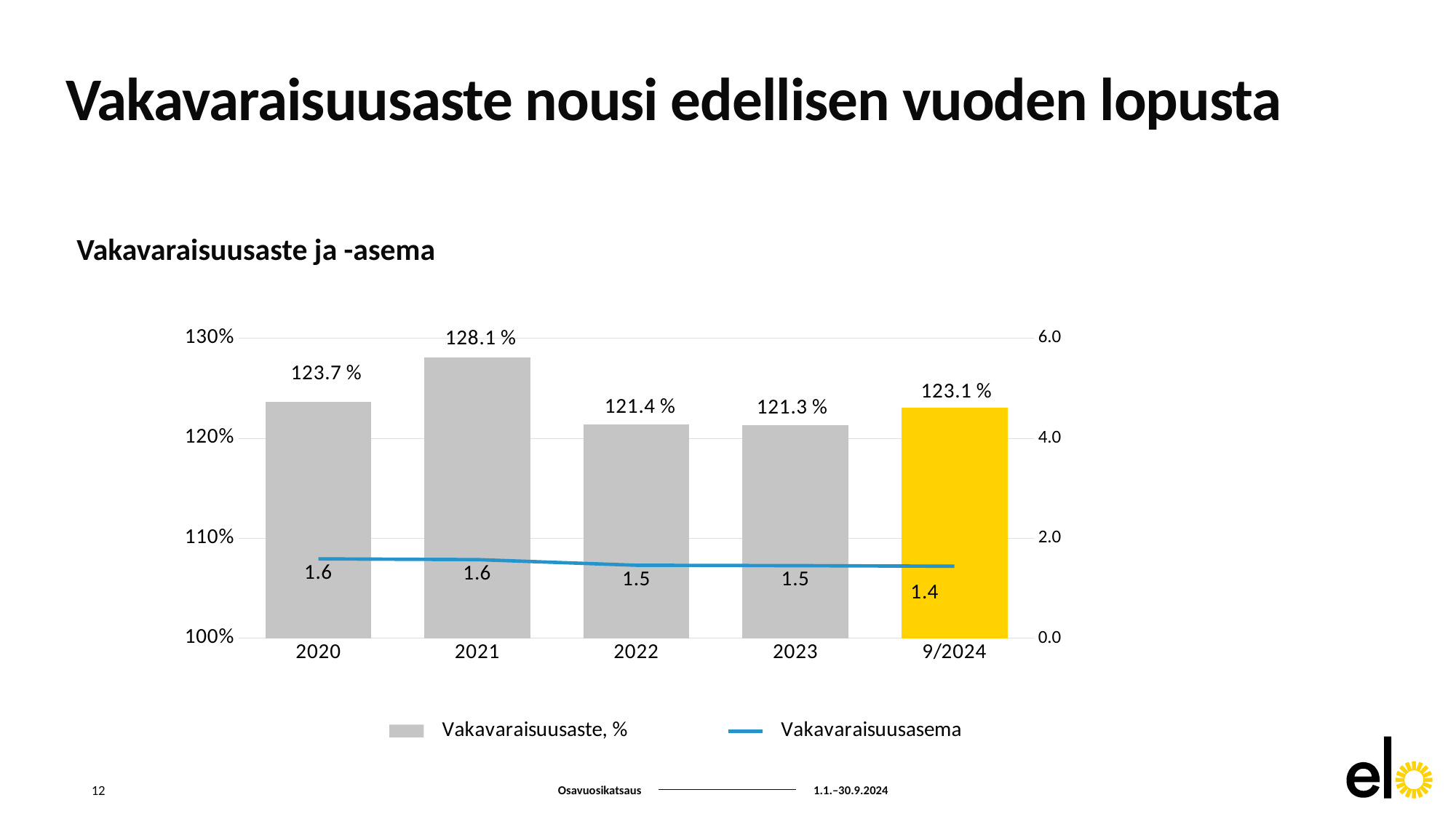
What is the Vakavaraisuusasema value for 2022? 1.5 Which year has the highest Vakavaraisuusaste, %? 2021 What is the Vakavaraisuusaste, % value for 9/2024? 123.1 % Does the Vakavaraisuusasema line rise or fall from 2020 to 9/2024? fall How many series does the legend list? 2 How many periods are shown on the x axis of the chart? 5 Which period has the lowest Vakavaraisuusasema value? 9/2024 What is the difference in Vakavaraisuusaste, % between 2021 and 2020? 4.4 % What is the Vakavaraisuusasema value for 9/2024? 1.4 Which is larger, the Vakavaraisuusaste, % for 2020 or for 9/2024? 2020 What is the title of the chart? Vakavaraisuusaste ja -asema What is the Vakavaraisuusaste, % value for 2021? 128.1 %